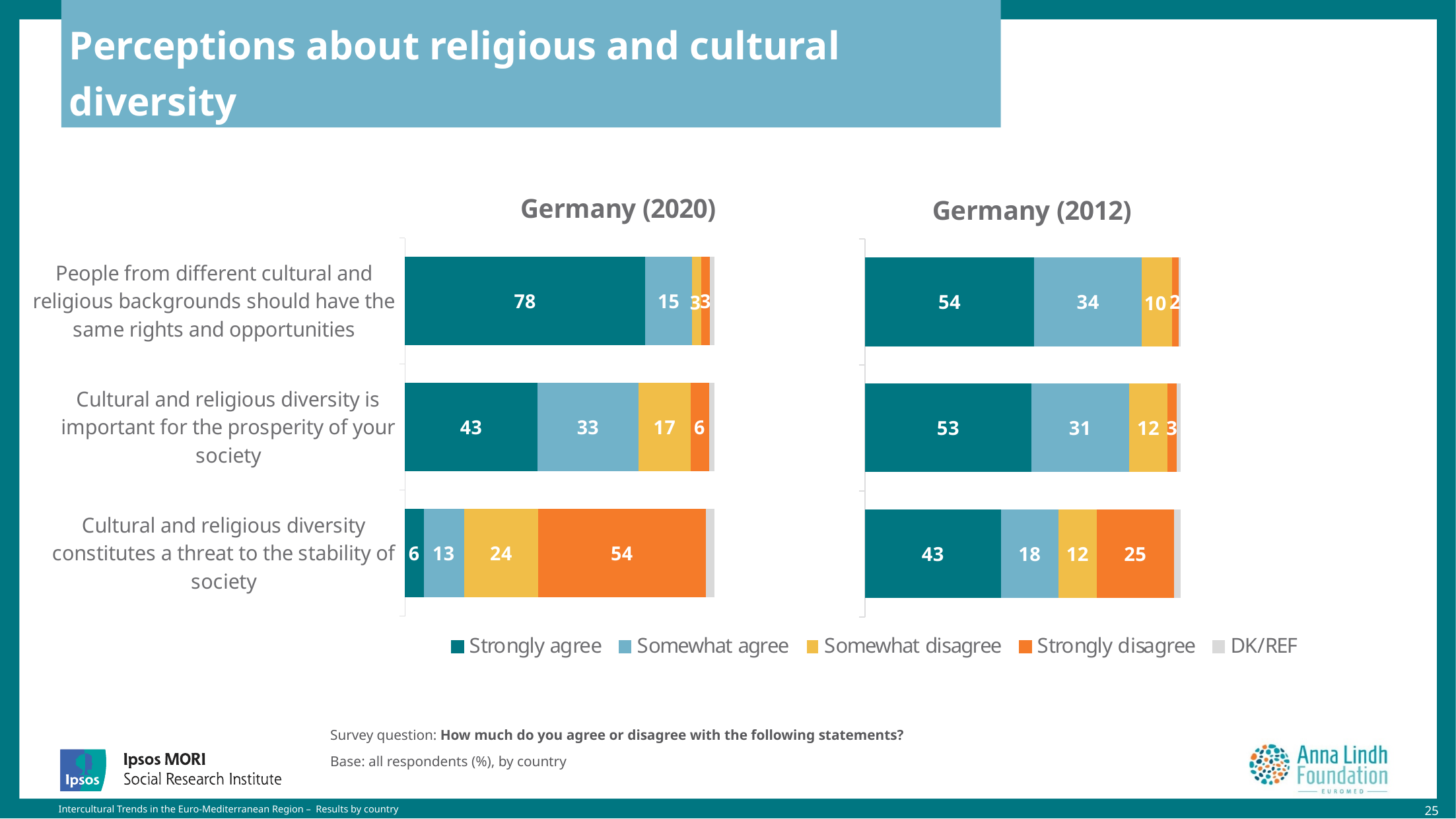
In the Germany (2012) chart, what percentage strongly disagree that cultural and religious diversity constitutes a threat to the stability of society? 25 Which colour represents Strongly disagree in the legend? Orange What type of chart is the Germany (2012) chart? Stacked bar chart In the Germany (2012) chart, what is the Somewhat disagree value for the statement that cultural and religious diversity is important for the prosperity of your society? 12 In the Germany (2020) chart, what is the Somewhat agree value for the statement that cultural and religious diversity is important for the prosperity of your society? 33 How many series does the legend list? 5 In the Germany (2020) chart, which statement has the highest Strongly disagree value? Cultural and religious diversity constitutes a threat to the stability of society Is the Strongly agree value for the threat to stability statement larger in the Germany (2020) chart or the Germany (2012) chart? Germany (2012) In the Germany (2020) chart, which statement has the lowest Strongly agree value? Cultural and religious diversity constitutes a threat to the stability of society What is the difference between the Strongly agree values for the same rights and opportunities statement in the Germany (2020) chart and the Germany (2012) chart? 24 How many statements are shown in the Germany (2020) chart? 3 In the Germany (2020) chart, what percentage strongly agree that people from different cultural and religious backgrounds should have the same rights and opportunities? 78